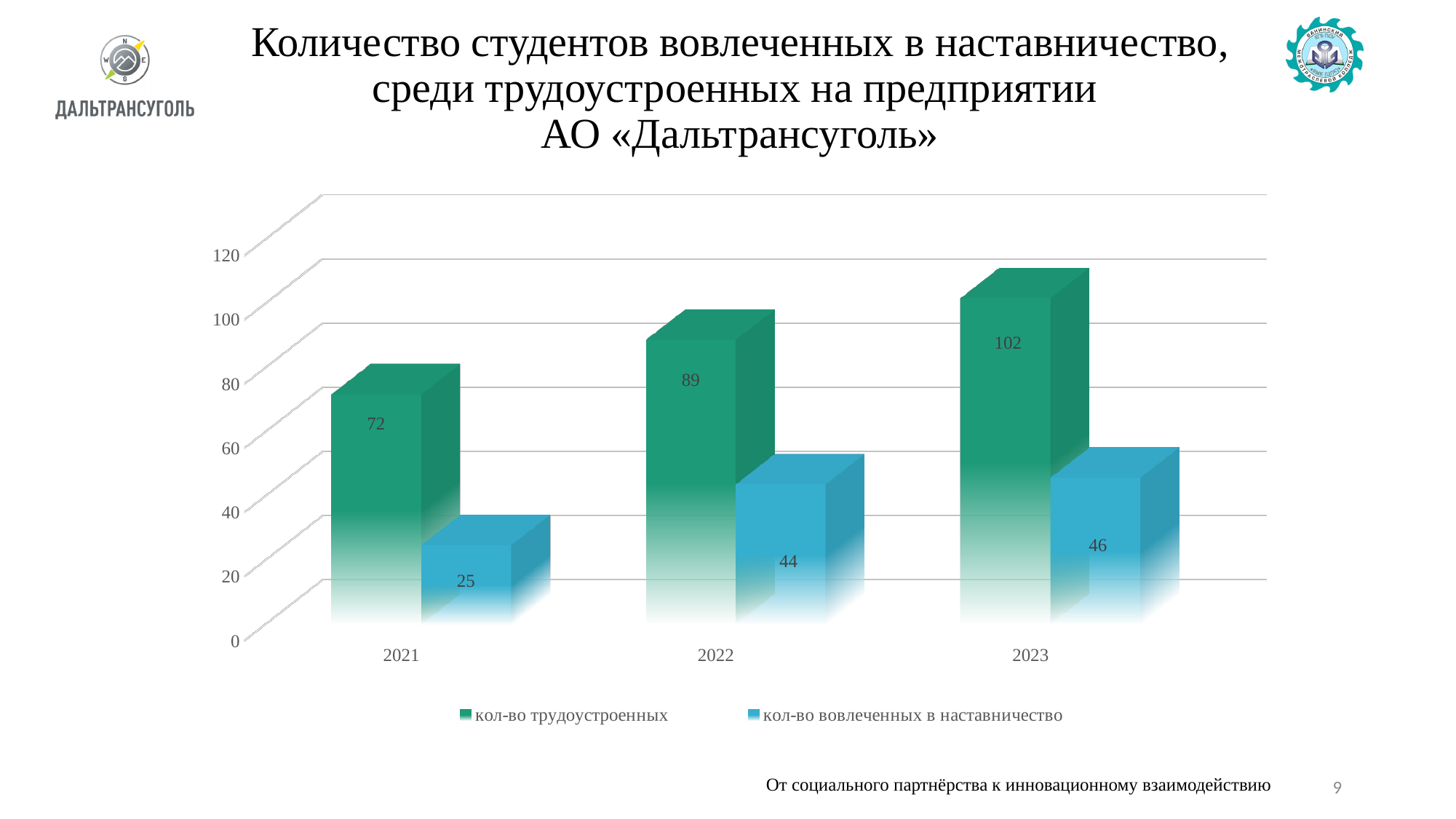
What kind of chart is shown on the slide? bar chart Does кол-во трудоустроенных rise or fall from 2021 to 2023? rise Which is larger: кол-во вовлеченных в наставничество in 2022 or in 2021? 2022 What is the difference between кол-во трудоустроенных and кол-во вовлеченных в наставничество in 2022? 45 What is the value of кол-во вовлеченных в наставничество for 2021? 25 What is the value of кол-во трудоустроенных for 2022? 89 How many series does the legend list? 2 Which year has the lowest value for кол-во трудоустроенных? 2021 How many years are shown on the x axis? 3 Is the value for кол-во трудоустроенных in 2023 greater or less than 100? greater Which year has the highest value for кол-во вовлеченных в наставничество? 2023 What is the value of кол-во трудоустроенных for 2023? 102